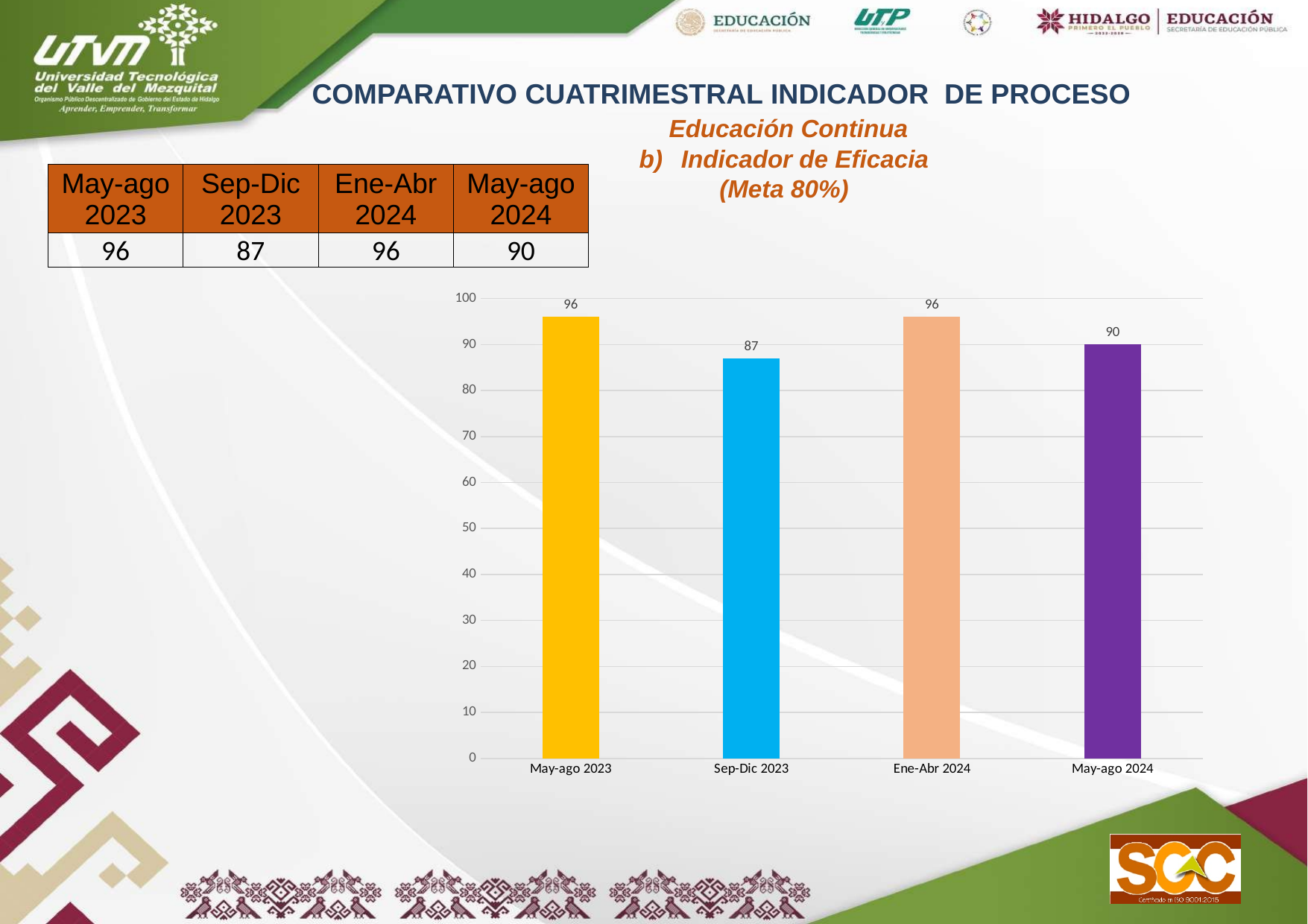
What is the value for May-ago 2024? 90 What colour is the bar for Sep-Dic 2023? blue Which period has the lowest value? Sep-Dic 2023 Which is larger, the value for Sep-Dic 2023 or the value for May-ago 2024? May-ago 2024 How many periods are shown on the x axis of the chart? 4 What kind of chart is shown on the slide? bar chart What is the value for Ene-Abr 2024? 96 Does the value rise or fall from Ene-Abr 2024 to May-ago 2024? fall Is the value for Sep-Dic 2023 greater or less than 80? greater What is the difference between the values for May-ago 2023 and May-ago 2024? 6 What is the difference between the values for Ene-Abr 2024 and Sep-Dic 2023? 9 What is the value for Sep-Dic 2023? 87